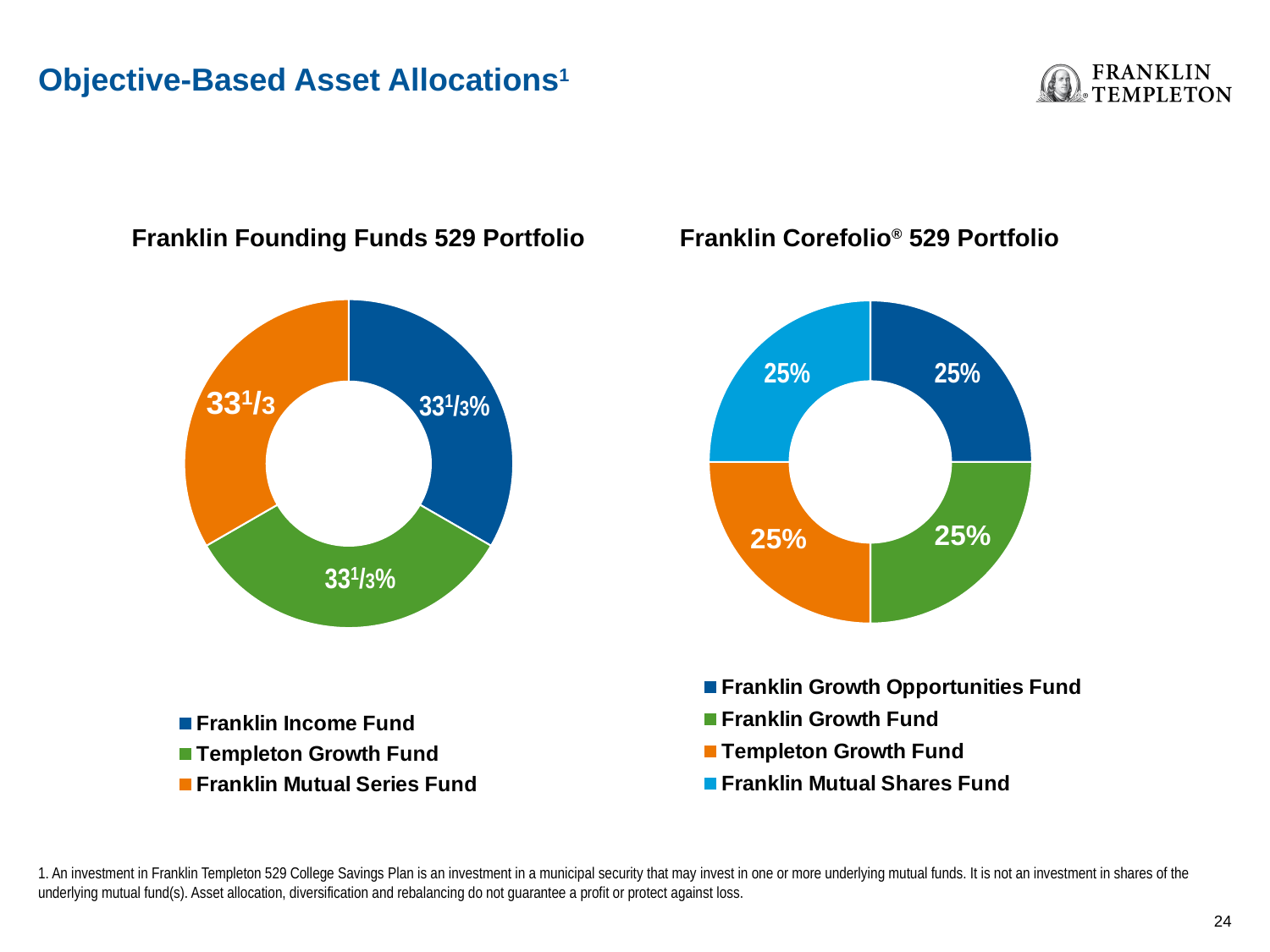
In the Franklin Corefolio 529 Portfolio chart, what is the value shown for Franklin Growth Opportunities Fund? 25% How many slices does the Franklin Founding Funds 529 Portfolio chart have? 3 In the Franklin Founding Funds 529 Portfolio chart, what is the value shown for Templeton Growth Fund? 33 1/3% In the Franklin Corefolio 529 Portfolio chart, what is the difference between the values for Franklin Growth Fund and Templeton Growth Fund? 0 How many slices does the Franklin Corefolio 529 Portfolio chart have? 4 How many entries does the legend of the Franklin Corefolio 529 Portfolio chart list? 4 In the Franklin Corefolio 529 Portfolio chart, what share of the portfolio does Templeton Growth Fund represent? 25% In the Franklin Founding Funds 529 Portfolio chart, which fund is shown in orange? Franklin Mutual Series Fund In the Franklin Corefolio 529 Portfolio chart, what is the value shown for Franklin Mutual Shares Fund? 25% What kind of chart is the Franklin Founding Funds 529 Portfolio chart? Donut (pie) chart In the Franklin Founding Funds 529 Portfolio chart, what label is printed on the Franklin Mutual Series Fund slice? 33 1/3 In the Franklin Founding Funds 529 Portfolio chart, what is the value shown for Franklin Income Fund? 33 1/3%